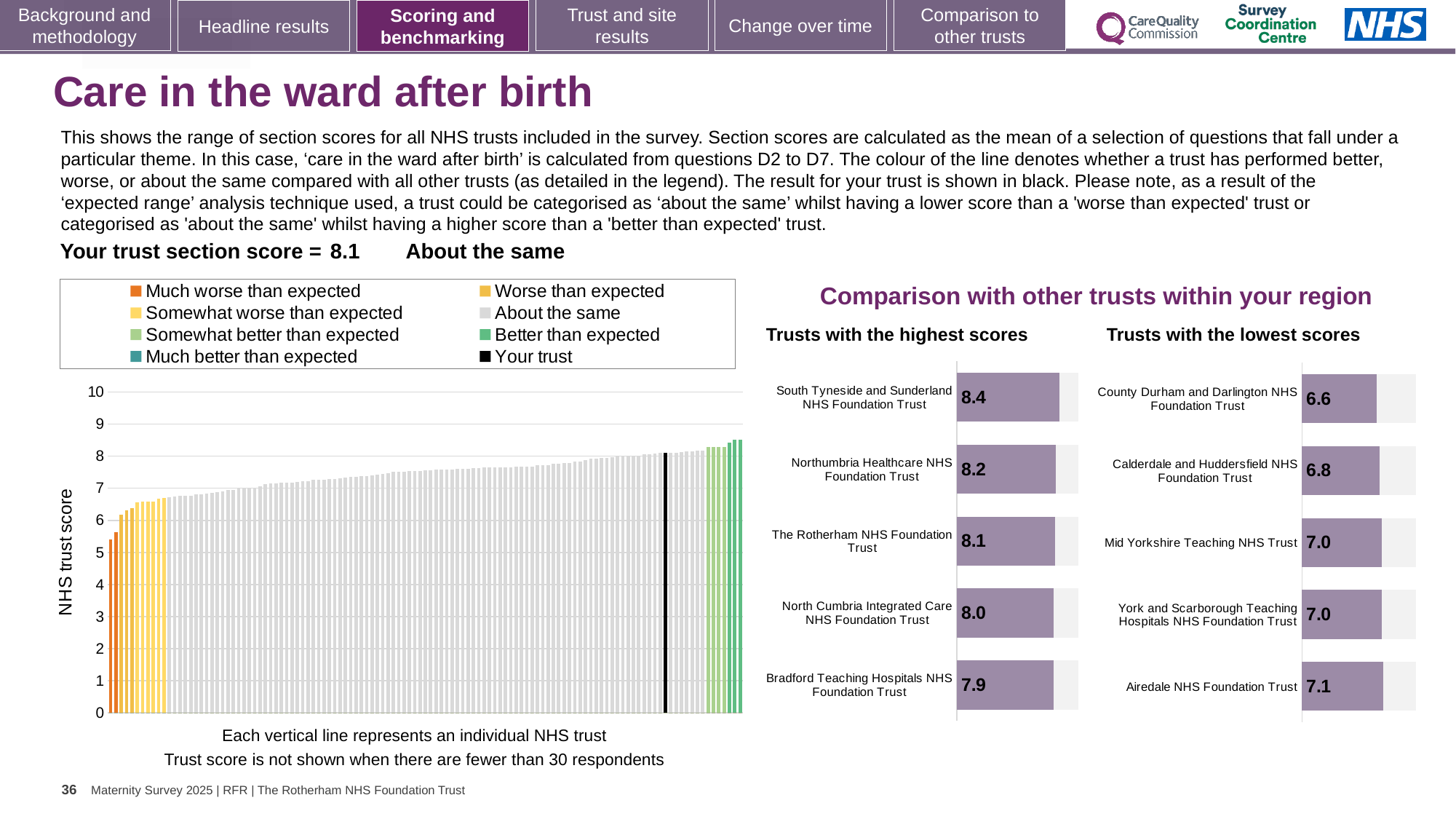
In the main chart on the left, do the trust scores rise or fall from left to right? rise How many trusts are listed in the 'Trusts with the lowest scores' chart? 5 In the 'Trusts with the lowest scores' chart, which has the higher score: Calderdale and Huddersfield NHS Foundation Trust or Airedale NHS Foundation Trust? Airedale NHS Foundation Trust What kind of chart is the main chart on the left of the slide? bar chart In the main chart on the left, is the value of the lowest bar greater or less than 6? less In the 'Trusts with the lowest scores' chart, what is the score for Airedale NHS Foundation Trust? 7.1 In the 'Trusts with the highest scores' chart, which trust has the highest score? South Tyneside and Sunderland NHS Foundation Trust In the 'Trusts with the highest scores' chart, what is the score for South Tyneside and Sunderland NHS Foundation Trust? 8.4 In the 'Trusts with the lowest scores' chart, which trust has the lowest score? County Durham and Darlington NHS Foundation Trust In the 'Trusts with the lowest scores' chart, what is the score for County Durham and Darlington NHS Foundation Trust? 6.6 In the 'Trusts with the highest scores' chart, what is the score for Bradford Teaching Hospitals NHS Foundation Trust? 7.9 In the 'Trusts with the highest scores' chart, what is the difference between the scores of South Tyneside and Sunderland NHS Foundation Trust and Northumbria Healthcare NHS Foundation Trust? 0.2